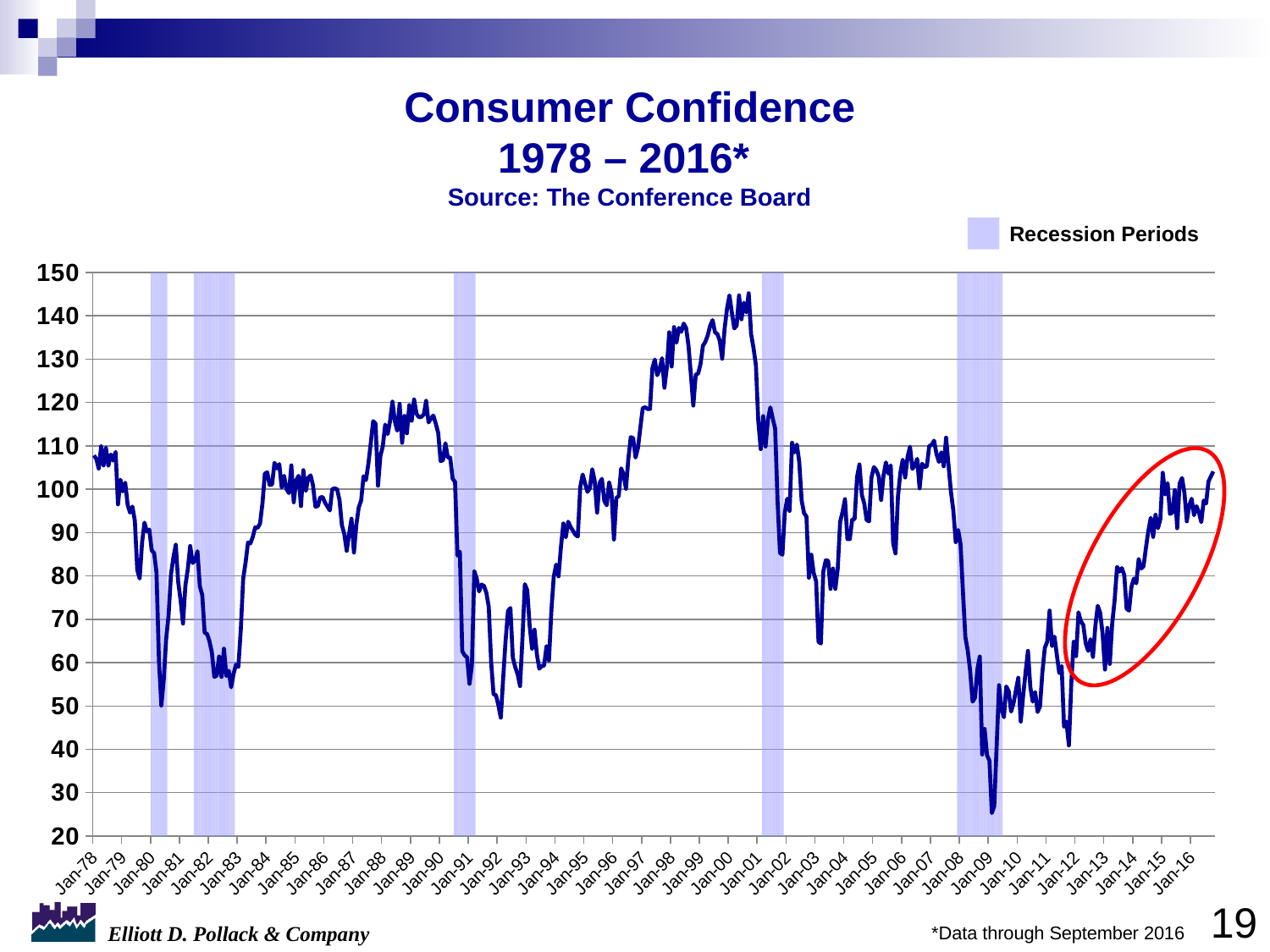
Is the peak value of consumer confidence around 2000 greater or less than 140? greater Does consumer confidence generally rise or fall between Jan-12 and Jan-16? Rise Which is higher: the peak in consumer confidence around 1989 or the peak around 2000? The peak around 2000 What is the title of the chart? Consumer Confidence 1978 – 2016* What do the shaded vertical bands on the chart represent, according to the legend? Recession Periods Is the lowest value of consumer confidence in 2009 greater or less than 30? less What kind of chart is shown on the slide? Line chart In which year does consumer confidence reach its lowest point on the chart? 2009 Is the value for Jan-92 greater or less than 60? less In which year does consumer confidence reach its highest point on the chart? 2000 Does consumer confidence generally rise or fall between Jan-07 and Jan-09? Fall